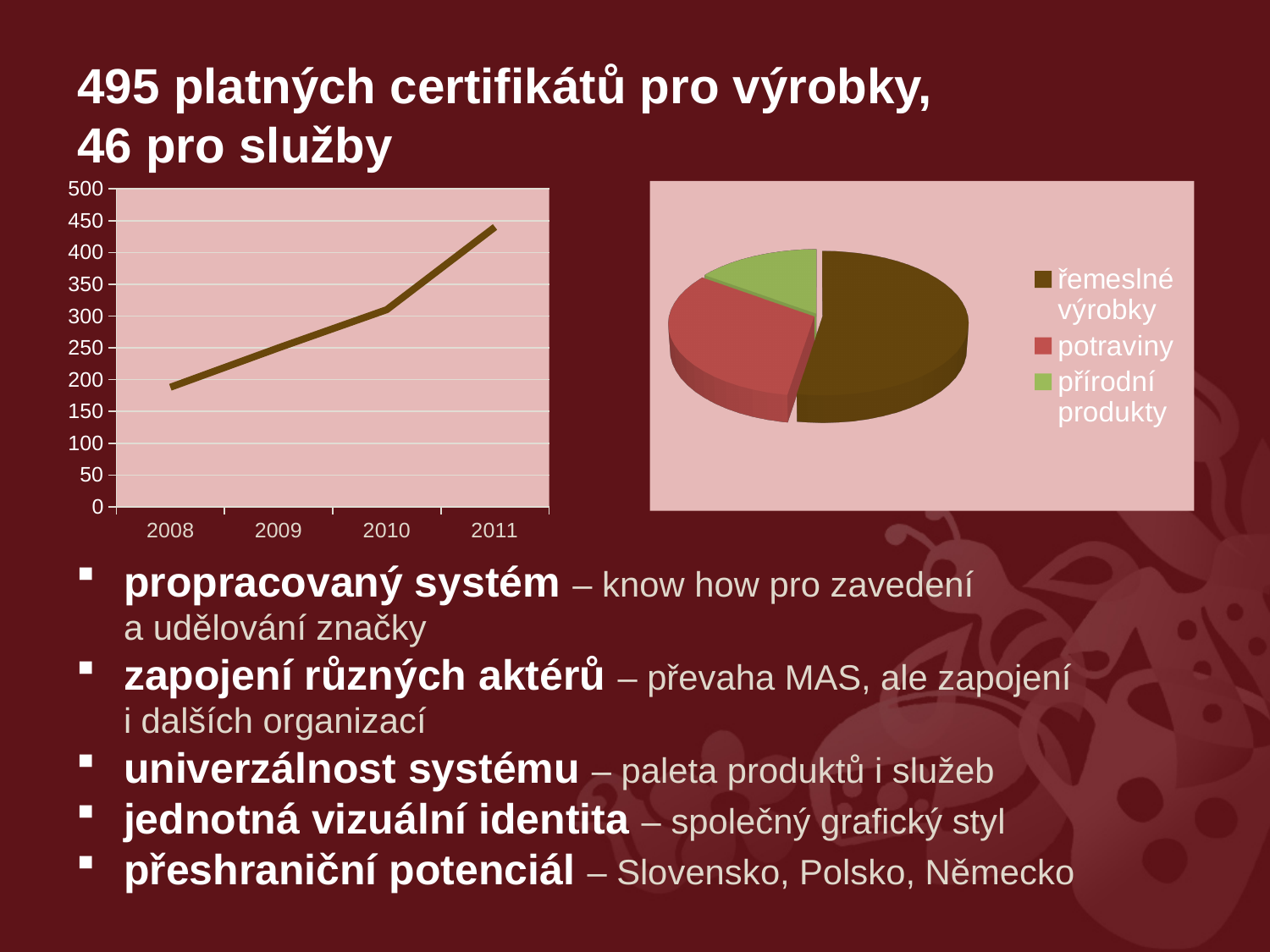
In the line chart on the left, how many years are shown on the x axis? 4 In the line chart on the left, is the value for 2009 greater or less than 200? greater What kind of chart is the chart on the left of the slide? line chart How many categories does the legend of the pie chart on the right list? 3 In the pie chart on the right, which category has the smallest slice? přírodní produkty In the line chart on the left, is the value for 2008 greater or less than 150? greater In the pie chart on the right, which slice is larger: potraviny or přírodní produkty? potraviny In the pie chart on the right, which category has the largest slice? řemeslné výrobky In the line chart on the left, is the value for 2011 greater or less than 400? greater In the line chart on the left, do the values rise or fall from 2008 to 2011? rise What kind of chart is the chart on the right of the slide? pie chart